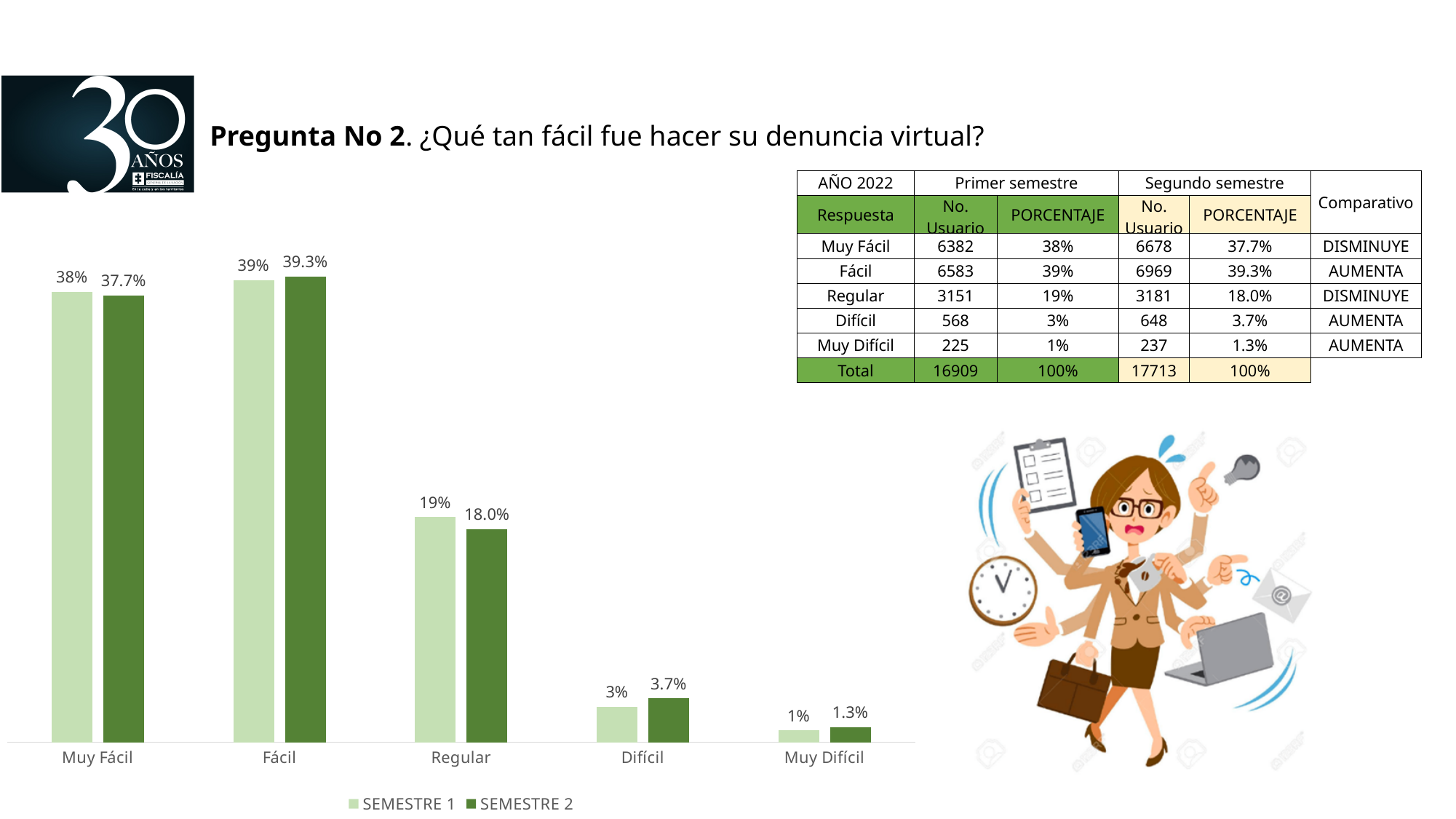
What is the difference between the SEMESTRE 2 values for Fácil and Regular? 21.3% Which category has the lowest SEMESTRE 1 value? Muy Difícil What is the SEMESTRE 2 value for Regular? 18.0% What is the SEMESTRE 1 value for Difícil? 3% How many series does the chart legend list? 2 What is the SEMESTRE 1 value for Fácil? 39% What are the two series names listed in the chart legend? SEMESTRE 1 and SEMESTRE 2 Which is larger: the SEMESTRE 1 value for Regular or the SEMESTRE 2 value for Regular? SEMESTRE 1 What is the SEMESTRE 2 value for Muy Fácil? 37.7% How many categories are shown on the x axis of the chart? 5 Which category has the highest SEMESTRE 2 value? Fácil What kind of chart is shown on the slide? Bar chart